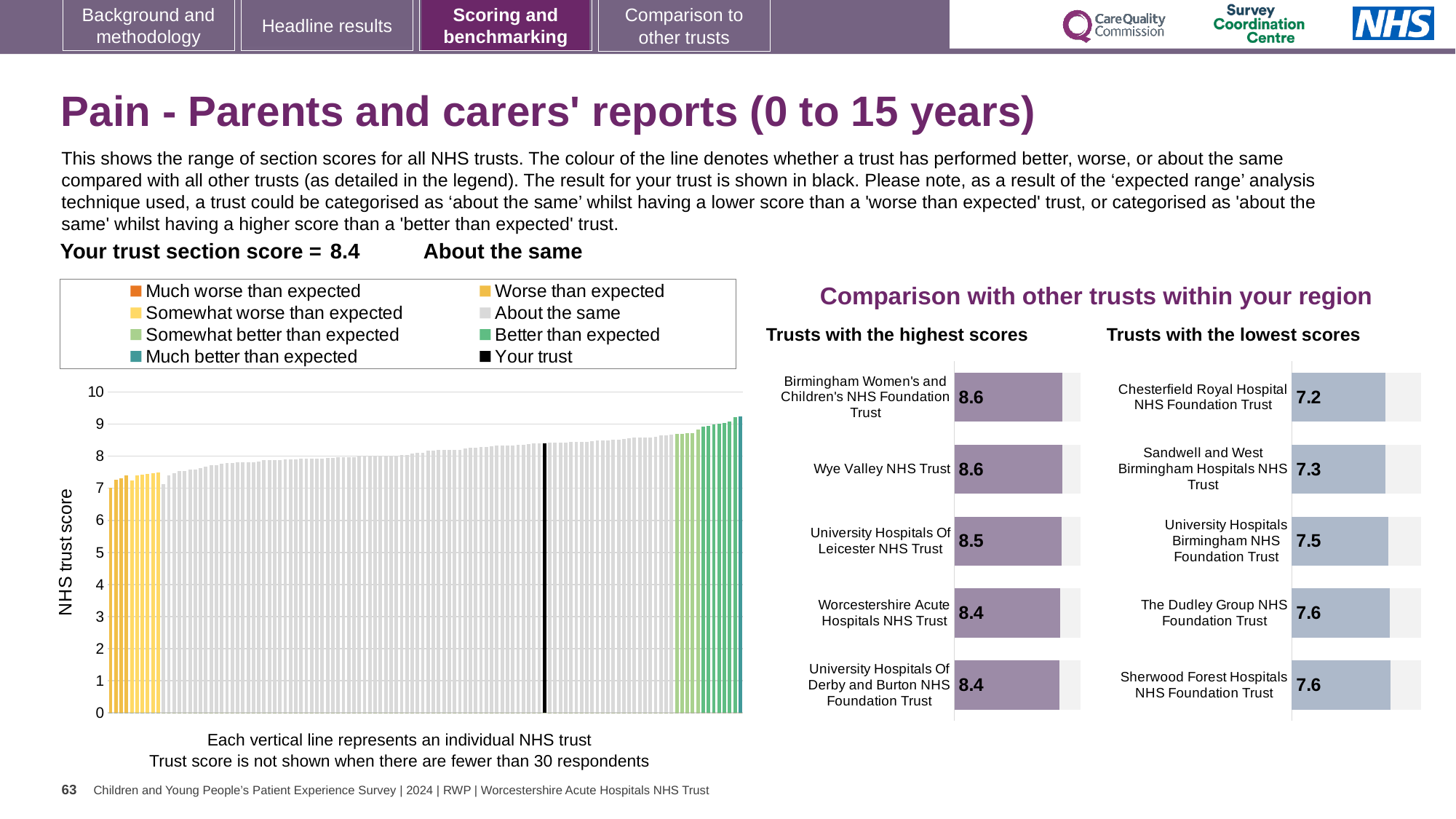
How many entries does the legend of the large chart on the left list? 8 In the large chart on the left showing the range of section scores, do the trust scores rise or fall from left to right? rise How many trusts are listed in the 'Trusts with the lowest scores' chart? 5 In the large chart on the left showing the range of section scores, is the value for the black 'Your trust' bar greater or less than 8? greater In the 'Trusts with the lowest scores' chart, which trust has the lowest score? Chesterfield Royal Hospital NHS Foundation Trust In the 'Trusts with the highest scores' chart, what is the score for Wye Valley NHS Trust? 8.6 In the 'Trusts with the highest scores' chart, what is the difference between the scores of Wye Valley NHS Trust and Worcestershire Acute Hospitals NHS Trust? 0.2 In the 'Trusts with the highest scores' chart, which has the larger score: University Hospitals Of Leicester NHS Trust or University Hospitals Of Derby and Burton NHS Foundation Trust? University Hospitals Of Leicester NHS Trust In the 'Trusts with the lowest scores' chart, what is the score for Chesterfield Royal Hospital NHS Foundation Trust? 7.2 In the 'Trusts with the lowest scores' chart, what is the difference between the scores of The Dudley Group NHS Foundation Trust and Chesterfield Royal Hospital NHS Foundation Trust? 0.4 In the 'Trusts with the highest scores' chart, what is the score for University Hospitals Of Leicester NHS Trust? 8.5 What kind of chart is the large chart on the left showing the range of section scores? bar chart